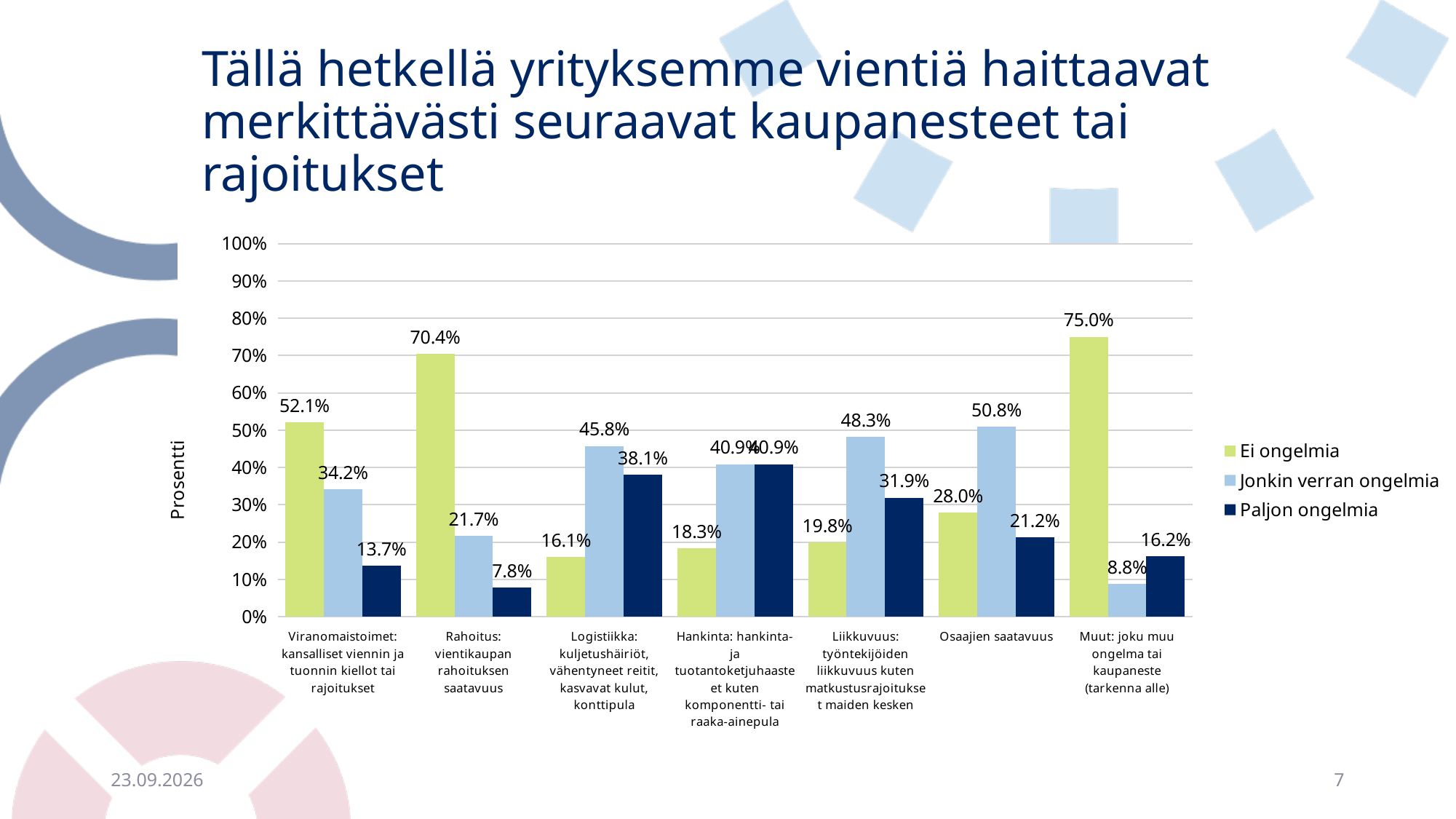
Which category has the lowest "Paljon ongelmia" value? Rahoitus: vientikaupan rahoituksen saatavuus Which category has the highest "Ei ongelmia" value? Muut: joku muu ongelma tai kaupaneste (tarkenna alle) What is the label of the y axis of the chart? Prosentti How many categories are shown on the x axis of the chart? 7 What is the value of "Jonkin verran ongelmia" for Osaajien saatavuus? 50.8% What is the difference between the "Jonkin verran ongelmia" and "Paljon ongelmia" values for Viranomaistoimet: kansalliset viennin ja tuonnin kiellot tai rajoitukset? 20.5% What type of chart is shown on the slide? Bar chart Which is larger for Liikkuvuus: the "Jonkin verran ongelmia" value or the "Paljon ongelmia" value? Jonkin verran ongelmia What is the value of "Paljon ongelmia" for Logistiikka: kuljetushäiriöt, vähentyneet reitit, kasvavat kulut, konttipula? 38.1% How many series does the legend list? 3 What is the value of "Jonkin verran ongelmia" for Muut: joku muu ongelma tai kaupaneste (tarkenna alle)? 8.8% What is the value of "Ei ongelmia" for Rahoitus: vientikaupan rahoituksen saatavuus? 70.4%